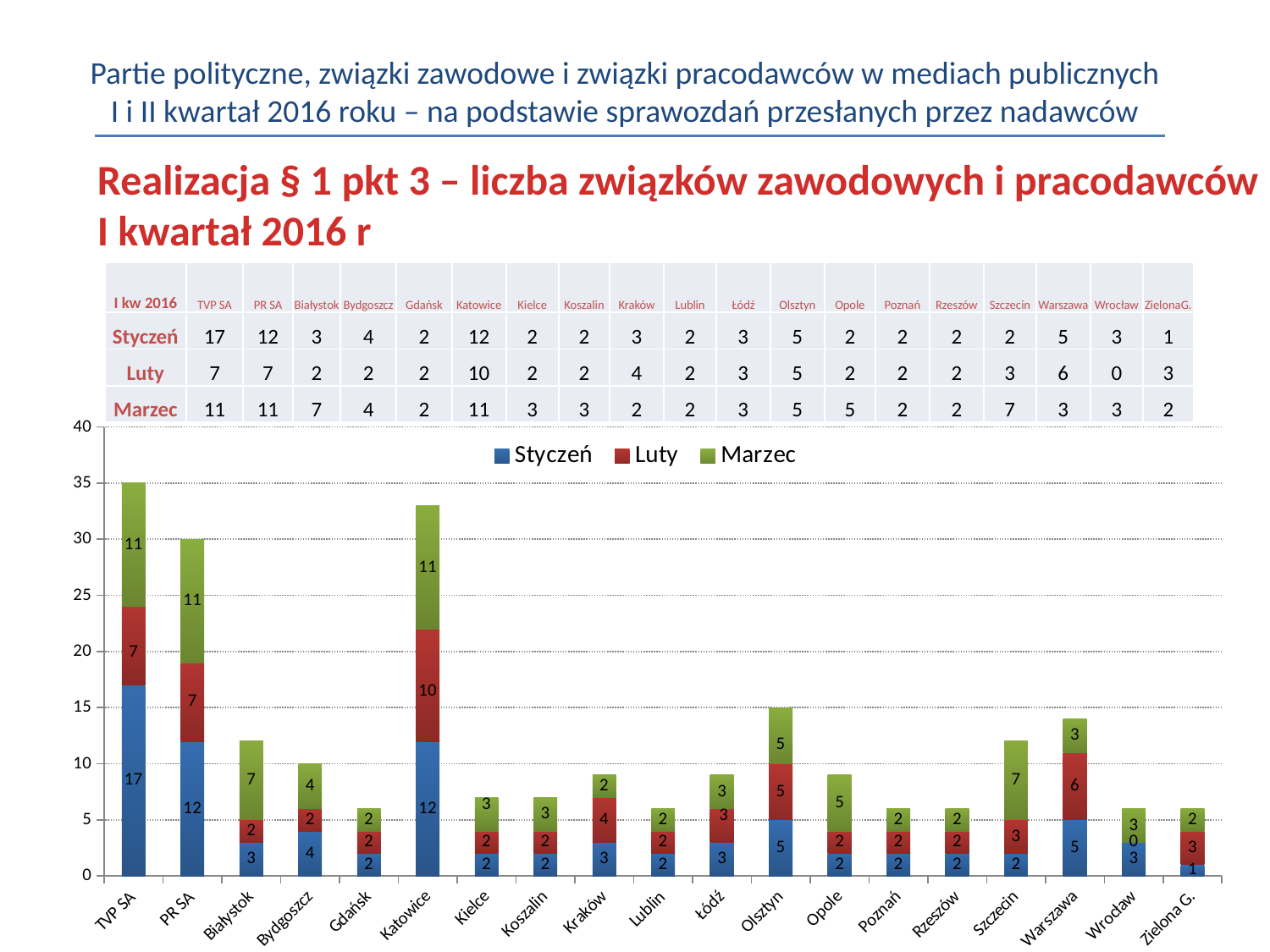
What is the Marzec value for Szczecin? 7 What kind of chart is shown on the slide? Stacked bar chart What is the difference between the Styczeń values for TVP SA and PR SA? 5 What is the Luty value for Katowice? 10 Which is larger, the Luty value for Warszawa or the Luty value for Szczecin? Warszawa What is the total of the stacked bar for Olsztyn? 15 What is the Styczeń value for TVP SA? 17 Which series is shown in green in the legend? Marzec How many categories are shown on the x axis? 19 Which category has the tallest stacked bar overall? TVP SA How many series does the legend list? 3 What is the total of the stacked bar for Katowice? 33